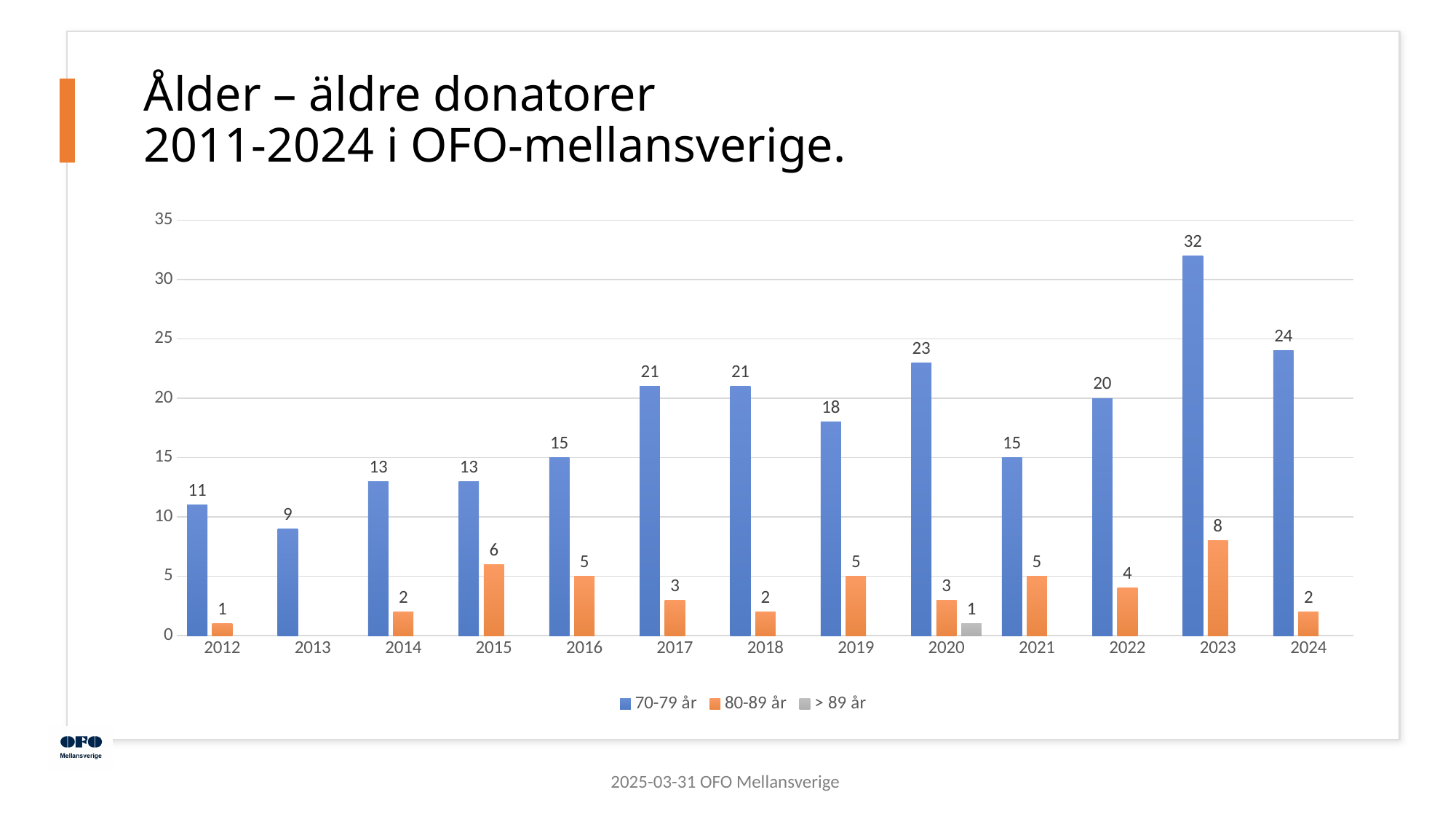
How many series does the legend list? 3 What kind of chart is shown on the slide? Bar chart What is the value for the 80-89 år series in 2015? 6 How many years are shown on the x axis? 13 What colour are the bars for the 80-89 år series? Orange Which is larger, the 80-89 år value for 2023 or for 2016? 2023 What is the value for the > 89 år series in 2020? 1 Which year has the highest value for the 70-79 år series? 2023 What is the value for the 70-79 år series in 2023? 32 What is the difference between the 70-79 år values for 2023 and 2024? 8 Is the 70-79 år value for 2020 greater or less than 20? greater Which year has the lowest value for the 70-79 år series? 2013